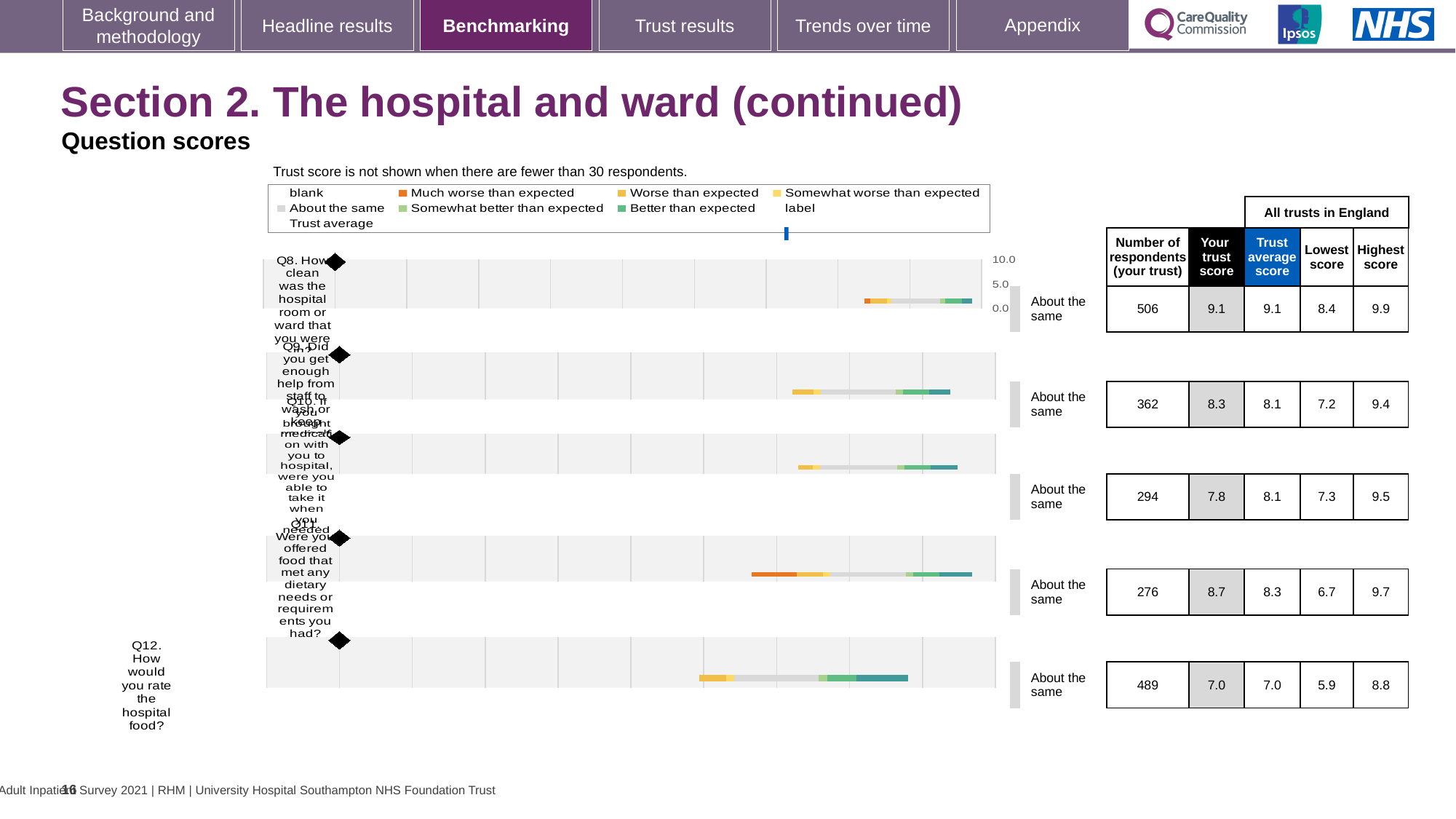
For Q9, which is larger: this trust's score or the trust average score? This trust's score (8.3) Which question has the highest trust score on this slide? Q8 Which question has the lowest trust score on this slide? Q12 What benchmark category is shown for every question on this slide? About the same How many respondents answered Q8 (How clean was the hospital room or ward) for this trust? 506 What is the highest score across all trusts in England for Q11 (Were you offered food that met any dietary needs or requirements you had)? 9.7 What kind of chart is used to show the question scores? Bar chart For Q10, what is the difference between the trust average score (8.1) and this trust's score (7.8)? 0.3 For Q12, what is the difference between the highest score (8.8) and the lowest score (5.9) across all trusts? 2.9 How many questions are plotted on this slide? 5 What is the trust score for Q12 (How would you rate the hospital food)? 7.0 What is the lowest score across all trusts in England for Q10 (medication brought with you to hospital)? 7.3